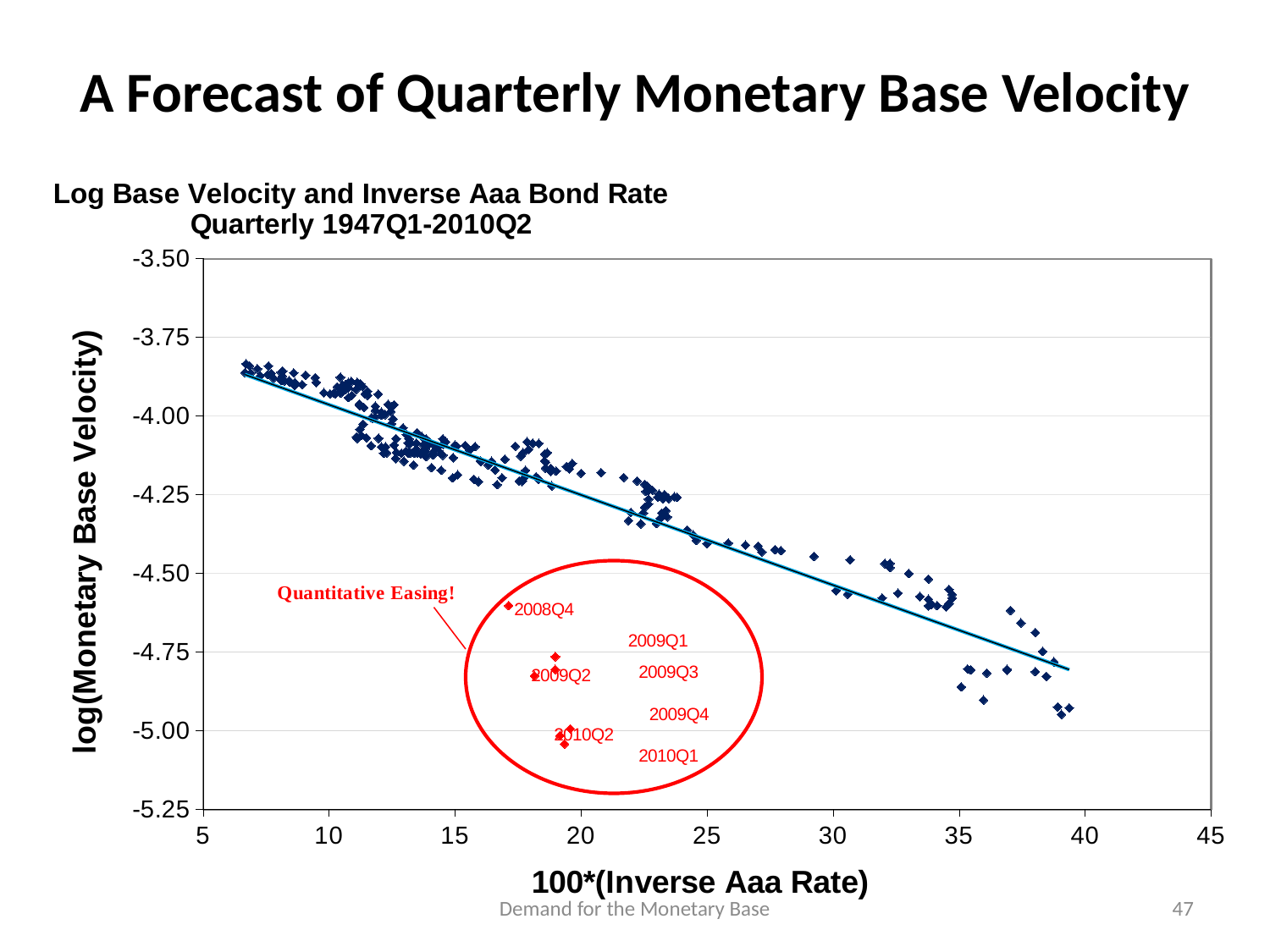
What is the highest value shown on the x axis? 45 Is the log(Monetary Base Velocity) value for the 2009Q2 point greater or less than -4.75? less What text is written in red next to the circled region of the chart? Quantitative Easing! What is the lowest value shown on the y axis? -5.25 How many quarter-labelled red points are inside the circled region? 7 What is the title of the x axis? 100*(Inverse Aaa Rate) Which point has the higher log(Monetary Base Velocity), 2008Q4 or 2010Q2? 2008Q4 Is the log(Monetary Base Velocity) value for the 2008Q4 point greater or less than -4.50? less Is the 100*(Inverse Aaa Rate) value for the 2008Q4 point greater or less than 20? less As 100*(Inverse Aaa Rate) increases along the x axis, do the log(Monetary Base Velocity) values generally rise or fall? fall What kind of chart is shown on the slide? scatter chart